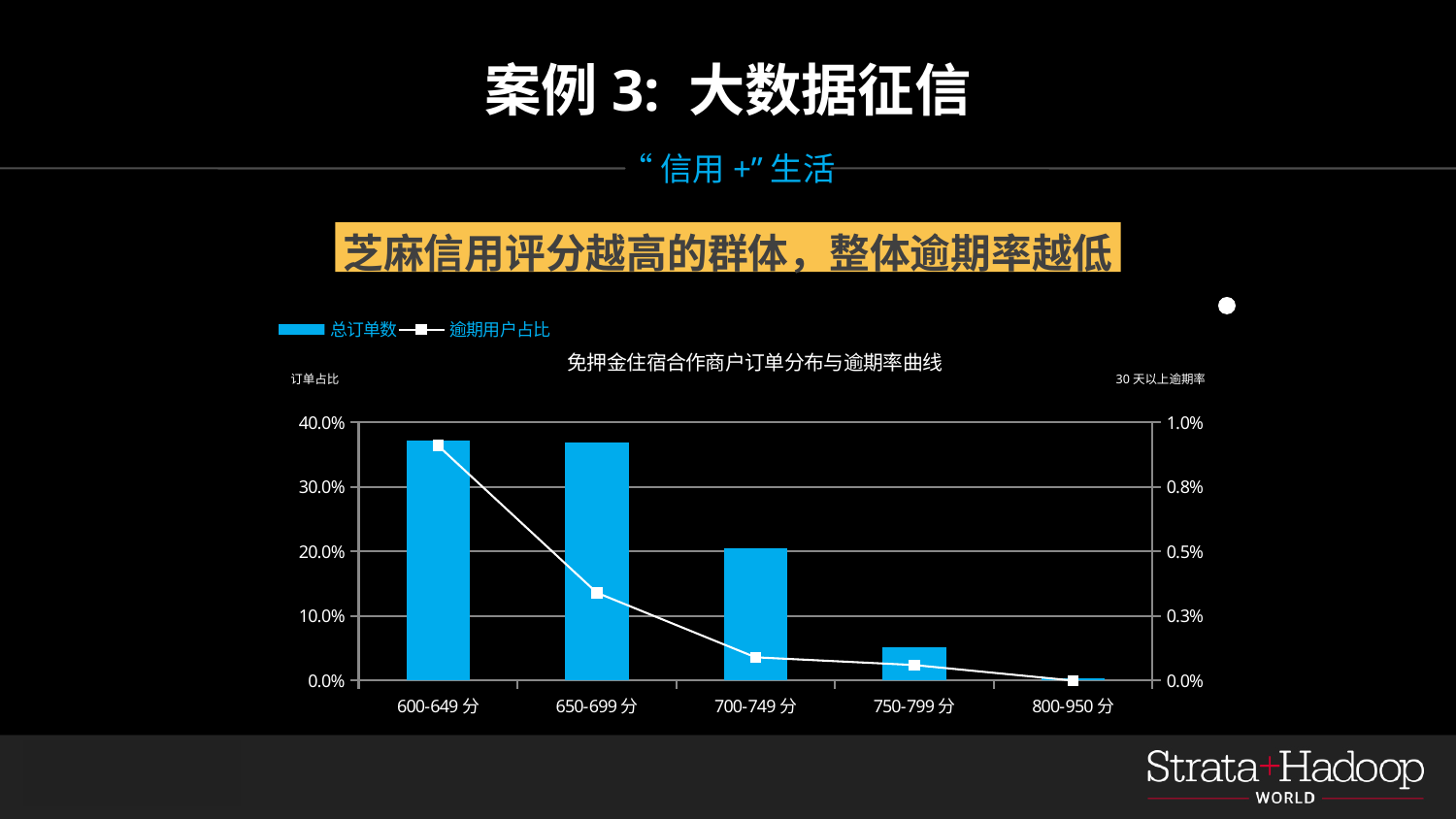
Is the 逾期用户占比 value for 650-699 分 greater or less than 0.5%? less Which category has the lowest 总订单数 bar? 800-950 分 What kind of chart is this? Combined bar and line chart How many score categories are shown on the x axis? 5 Is the 总订单数 value for 700-749 分 greater or less than 30.0%? less Which has the larger 总订单数 bar, 700-749 分 or 750-799 分? 700-749 分 Does the 逾期用户占比 line rise or fall as the score range increases along the x axis? Fall How many series does the chart legend list? 2 Is the 逾期用户占比 value for 600-649 分 greater or less than 0.8%? greater Which category has the highest 逾期用户占比 value? 600-649 分 What is the title of the chart? 免押金住宿合作商户订单分布与逾期率曲线